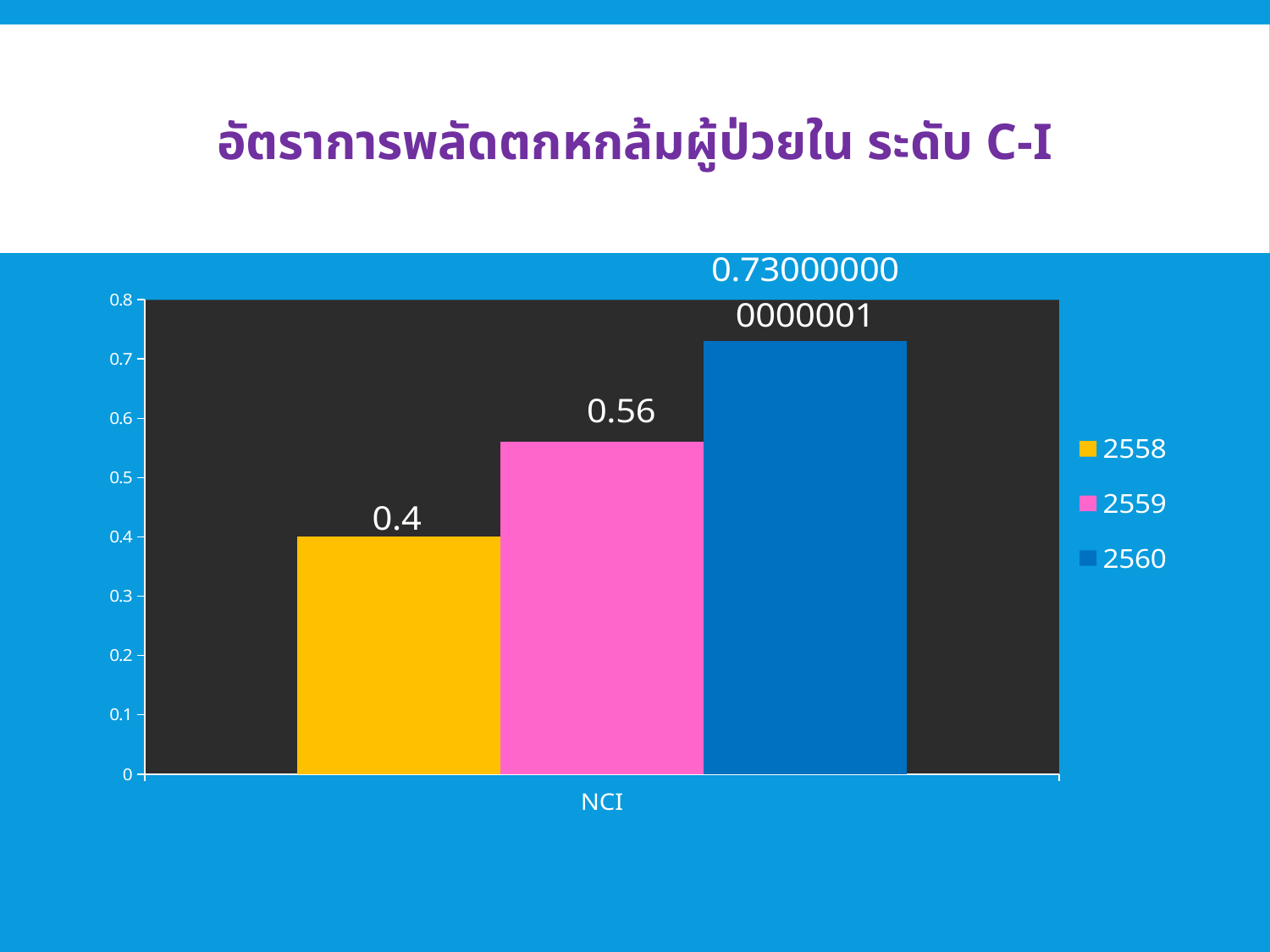
Is the value for 2560 greater or less than 0.7? greater What is the value for the 2559 series in the chart? 0.56 What colour is the bar for the 2559 series? pink Which series has the highest value in the chart? 2560 What is the difference between the values for 2559 and 2558? 0.16 What is the value for the 2558 series in the chart? 0.4 What is the category label shown on the x axis? NCI How many series does the legend list? 3 Is the value for 2559 greater or less than 0.6? less Which series has the lowest value in the chart? 2558 Which is larger, the value for 2559 or the value for 2558? 2559 What kind of chart is shown on the slide? bar chart